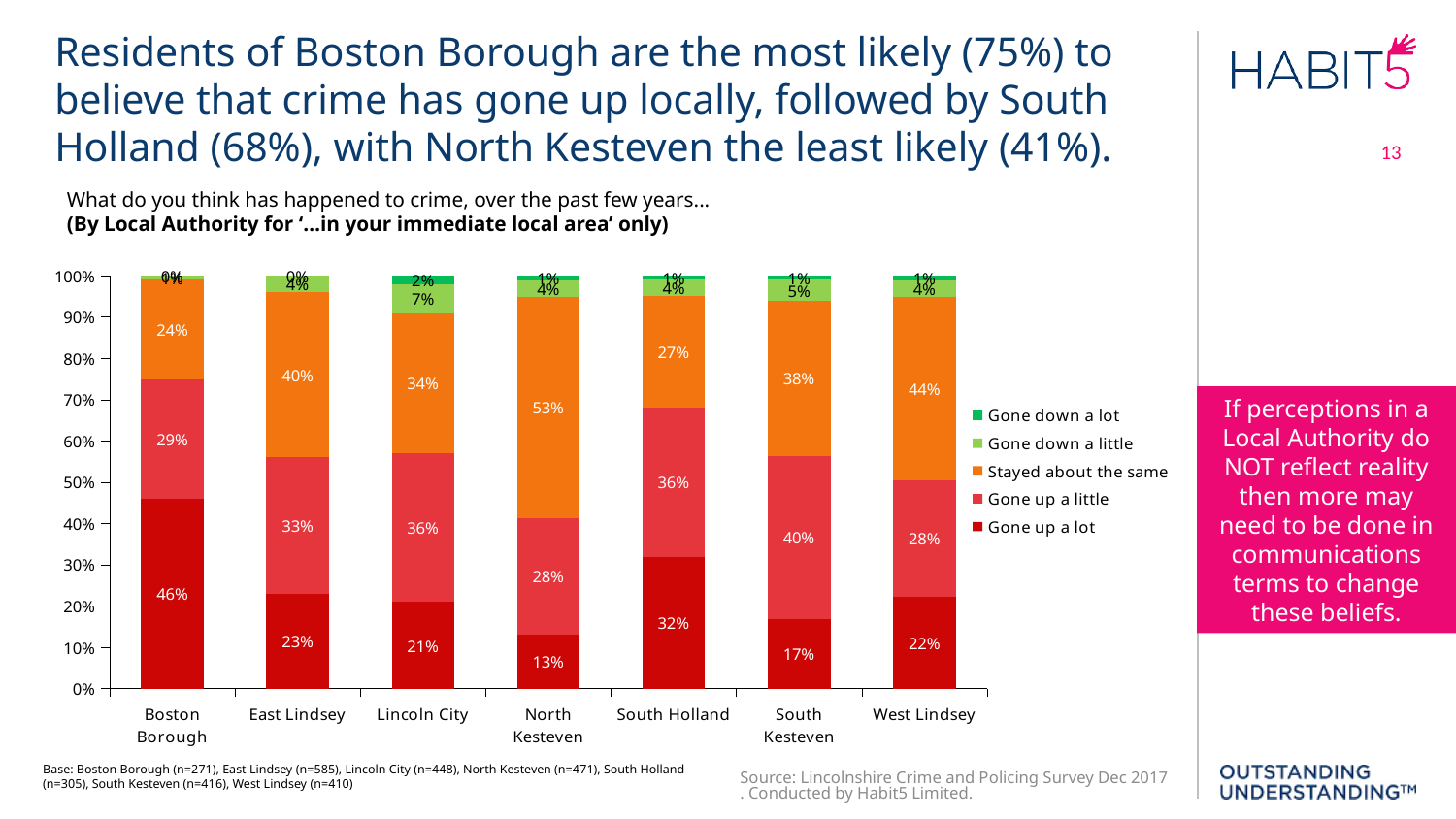
What is the difference between the 'Gone up a lot' values for Boston Borough and South Holland? 14% How many local authorities are shown on the x axis of the chart? 7 Which local authority has the highest 'Stayed about the same' value? North Kesteven Which local authority has the lowest 'Gone up a lot' value? North Kesteven What percentage of Lincoln City residents said crime has 'Gone down a little'? 7% Which is larger: the 'Gone up a little' value for Lincoln City or for West Lindsey? Lincoln City What percentage of Boston Borough residents said crime has 'Gone up a lot'? 46% Which local authority has the highest 'Gone up a lot' value? Boston Borough How many series does the chart legend list? 5 What is the 'Gone up a little' value for South Kesteven? 40% What type of chart is shown on the slide? Stacked bar chart What is the 'Stayed about the same' value for North Kesteven? 53%